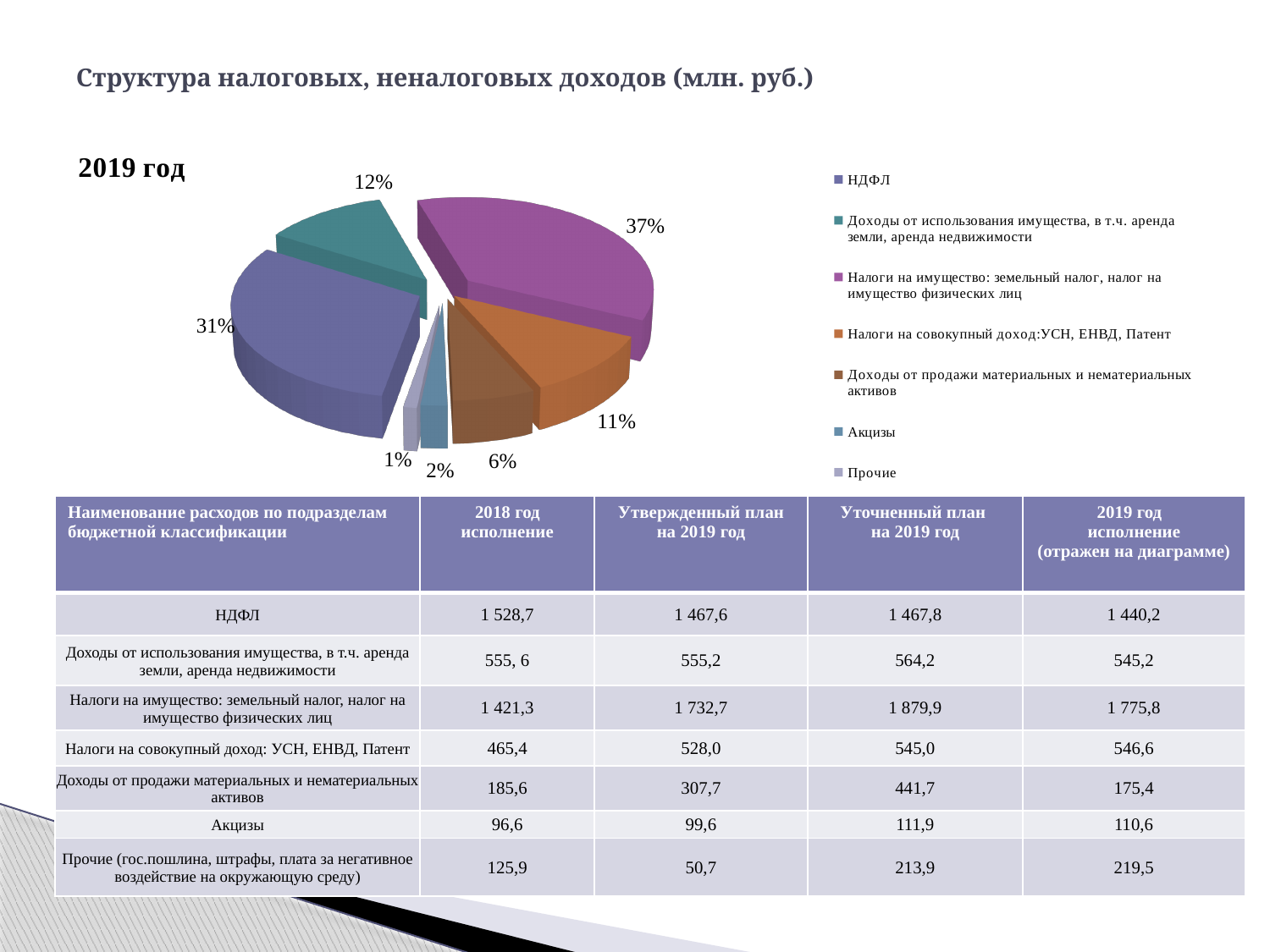
What is the difference in percentage points between the slice for Налоги на имущество and the slice for НДФЛ? 6 percentage points How many slices does the pie chart have? 7 What share of the pie does the slice for Акцизы have? 2% Which slice is larger: Доходы от продажи материальных и нематериальных активов or Налоги на совокупный доход: УСН, ЕНВД, Патент? Налоги на совокупный доход: УСН, ЕНВД, Патент What share of the pie does the slice for Доходы от использования имущества, в т.ч. аренда земли, аренда недвижимости have? 12% What share of the pie does the slice for НДФЛ have? 31% What kind of chart is shown on the slide? Pie chart Which category has the largest slice of the pie? Налоги на имущество: земельный налог, налог на имущество физических лиц How many entries does the legend list? 7 Which category has the smallest slice of the pie? Прочие